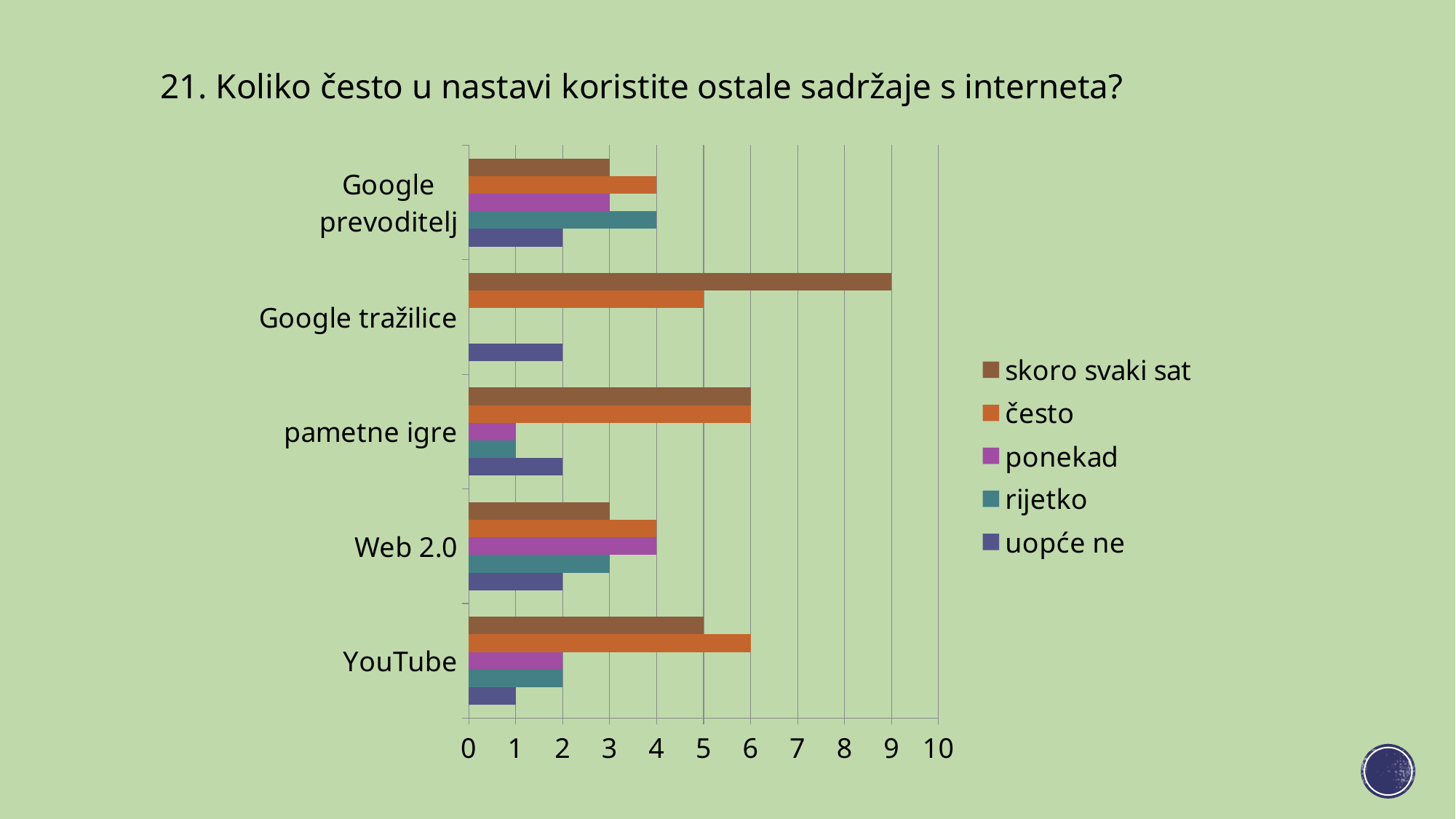
Is the value for 'skoro svaki sat' for Google tražilice greater or less than 8? greater What is the value for 'uopće ne' for YouTube? 1 Which category has the highest value for 'skoro svaki sat'? Google tražilice What is the value for 'često' for YouTube? 6 How many series does the legend list? 5 What kind of chart is shown on the slide? bar chart How many categories are shown on the chart? 5 What is the difference between the 'skoro svaki sat' values for Google tražilice and Google prevoditelj? 6 What is the title of the chart? 21. Koliko često u nastavi koristite ostale sadržaje s interneta? Which category has the lowest value for 'uopće ne'? YouTube What is the value for 'skoro svaki sat' for Google tražilice? 9 Which is larger for pametne igre: the 'često' value or the 'ponekad' value? često